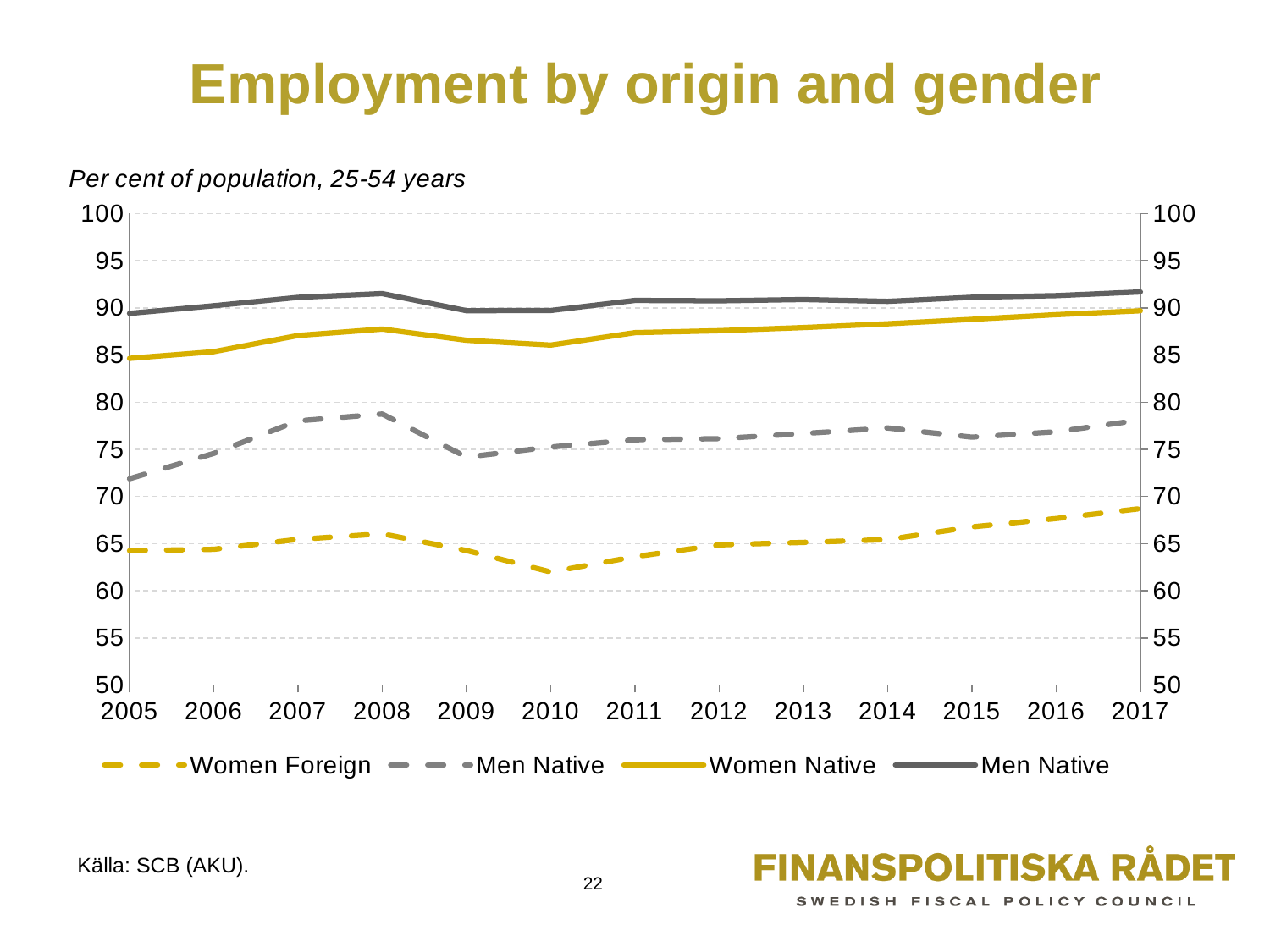
What unit does the subtitle above the chart say the values are in? Per cent of population, 25-54 years In which year does the Women Foreign series reach its lowest point? 2010 Which is larger in 2012, Women Native or Women Foreign? Women Native Is the value for Women Native in 2017 greater or less than 85? greater Is the value for Women Foreign in 2017 greater or less than 65? greater What kind of chart is shown on the slide? line chart Does the Women Foreign series rise or fall from 2010 to 2017? rise Is the value of the dashed grey line in 2008 greater or less than 75? greater How many series does the legend list? 4 Which series has the lowest values across the whole period? Women Foreign How many years are plotted along the x axis? 13